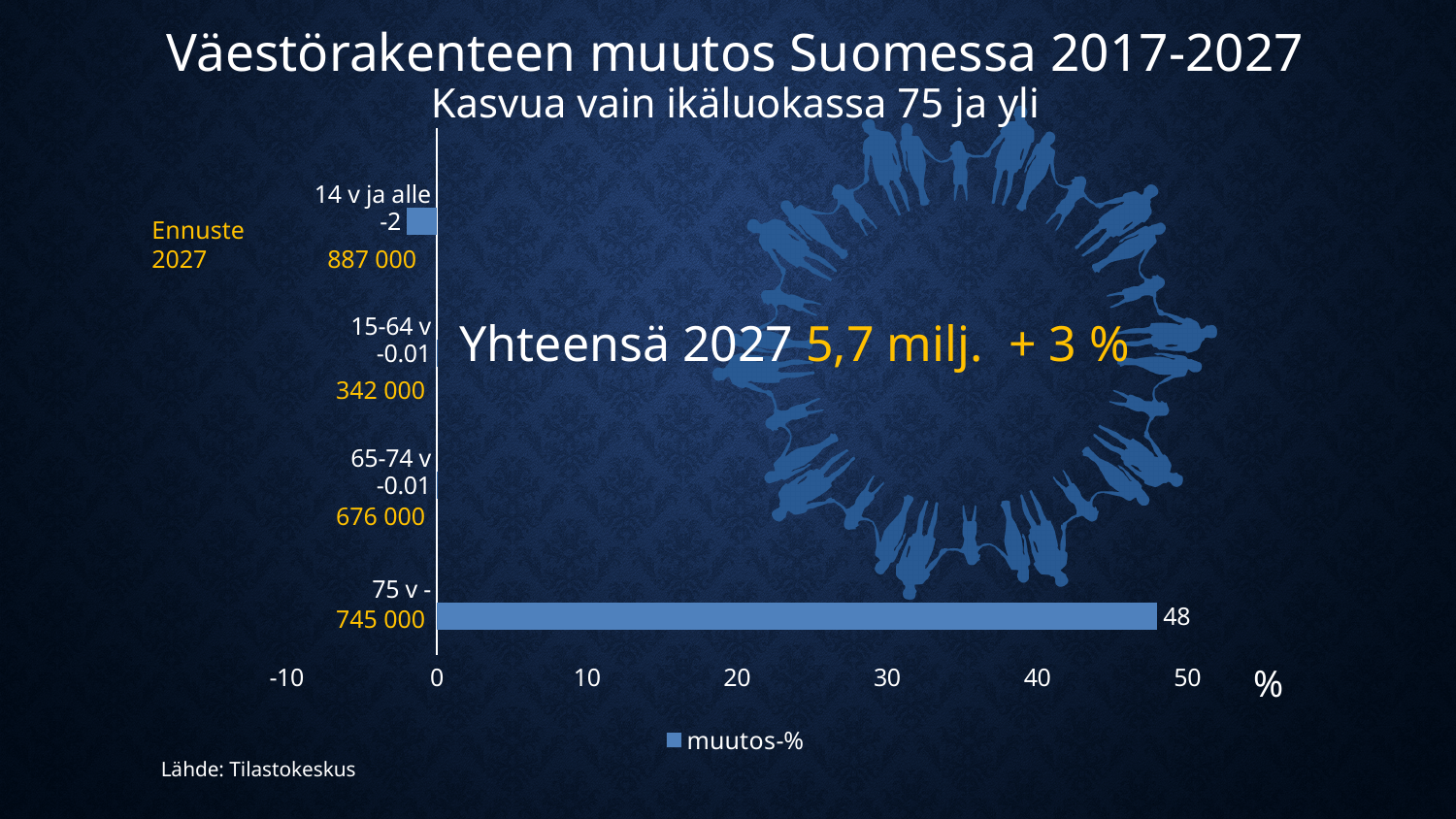
Which category has the highest value? 75 v - What is the name of the series in the legend? muutos-% Which category has the lowest value? 14 v ja alle What is the value for the 75 v - category? 48 How many categories are shown in the chart? 4 What is the value for the 15-64 v category? -0.01 Which is larger, the value for 75 v - or the value for 65-74 v? 75 v - What kind of chart is shown on the slide? bar chart What is the difference between the values for 75 v - and 14 v ja alle? 50 What is the value for the 14 v ja alle category? -2 Is the value for 75 v - greater or less than 40? greater How many series does the legend list? 1